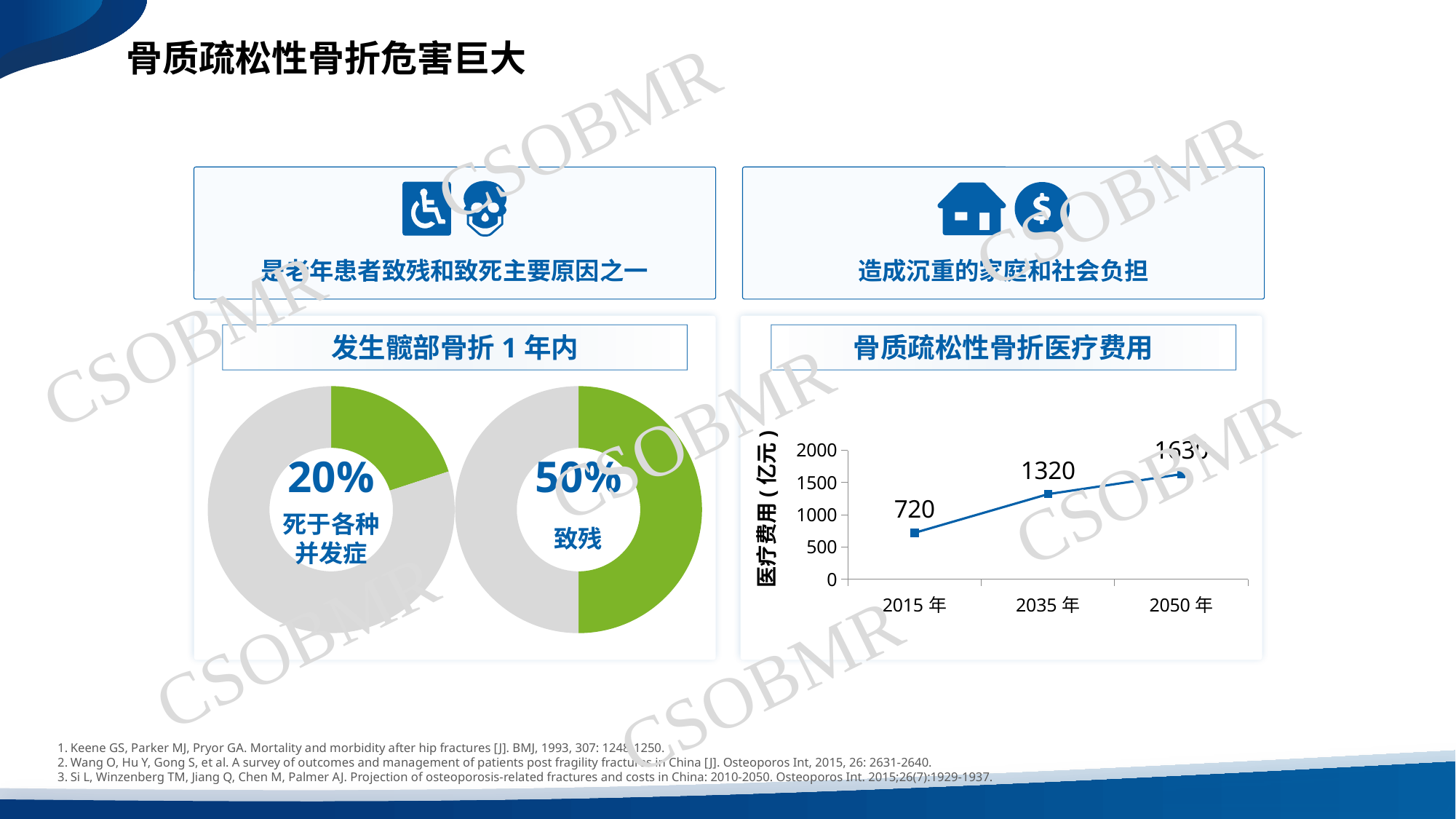
In the line chart titled 骨质疏松性骨折医疗费用, what is the value for 2015 年? 720 In the donut charts under 发生髋部骨折 1 年内, what percentage is shown for 致残? 50% In the line chart titled 骨质疏松性骨折医疗费用, is the value for 2050 年 greater or less than 1500? greater What kind of chart is the chart titled 骨质疏松性骨折医疗费用? line chart In the line chart titled 骨质疏松性骨折医疗费用, do the values rise or fall from 2015 年 to 2050 年? rise What is the y-axis label of the line chart titled 骨质疏松性骨折医疗费用? 医疗费用（亿元） How many data points are plotted in the line chart titled 骨质疏松性骨折医疗费用? 3 In the line chart titled 骨质疏松性骨折医疗费用, which year has the highest value? 2050 年 In the donut charts under 发生髋部骨折 1 年内, what percentage is shown for 死于各种并发症? 20% In the line chart titled 骨质疏松性骨折医疗费用, what is the difference between the values for 2035 年 and 2015 年? 600 In the line chart titled 骨质疏松性骨折医疗费用, which year has the lowest value? 2015 年 In the line chart titled 骨质疏松性骨折医疗费用, what is the value for 2035 年? 1320